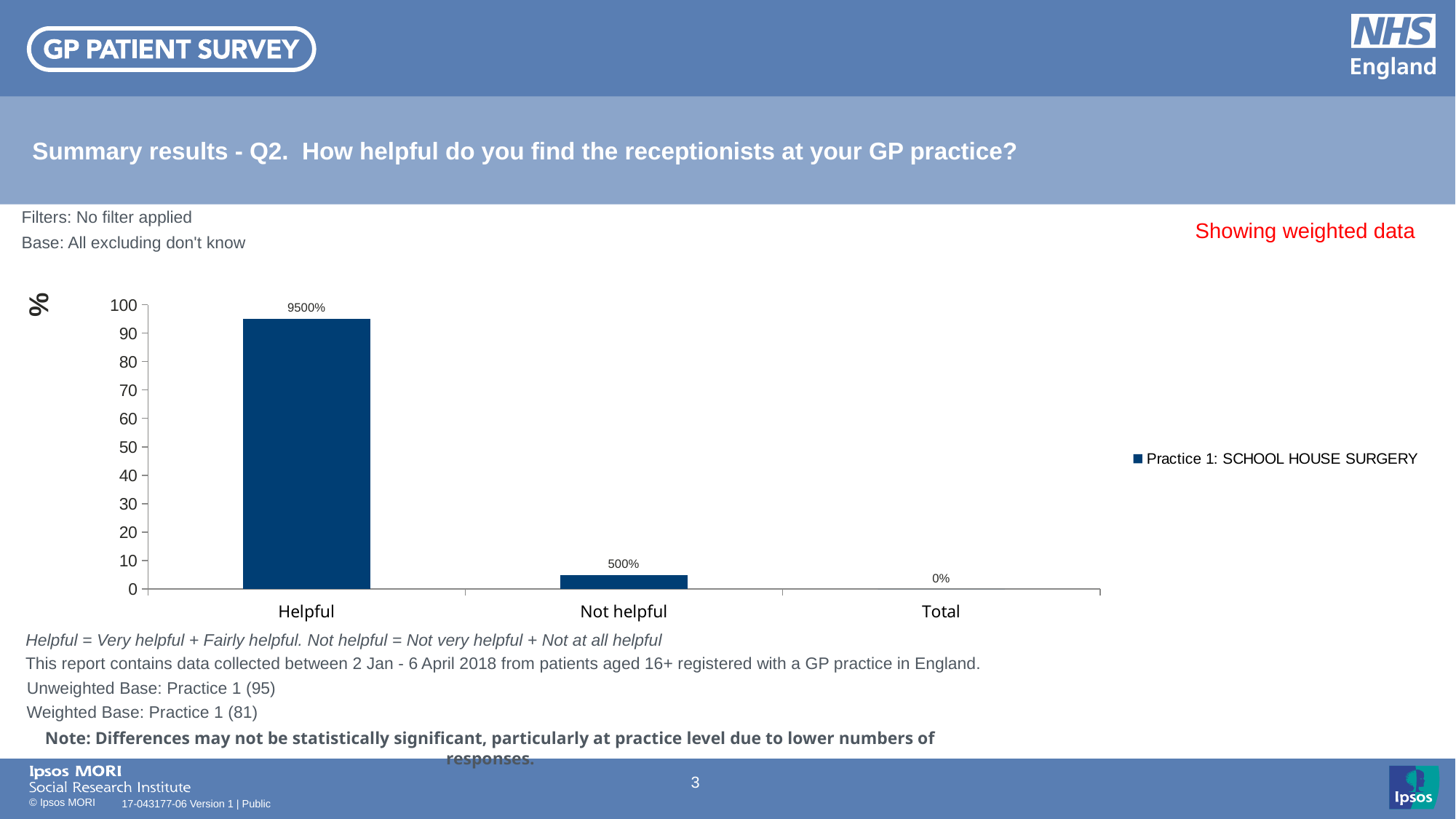
What is the data label shown for the Not helpful bar? 500% Which is larger, the bar for Helpful or the bar for Not helpful? Helpful What is the name of the series in the legend? Practice 1: SCHOOL HOUSE SURGERY Which category has the lowest value? Total What is the data label shown for the Total category? 0% What kind of chart is shown on the slide? Bar chart How many categories are shown on the x axis? 3 Is the bar for Not helpful greater or less than 10 on the y axis? less Which category has the highest bar? Helpful Is the bar for Helpful greater or less than 90 on the y axis? greater What is the data label shown for the Helpful bar? 9500% How many series does the legend list? 1